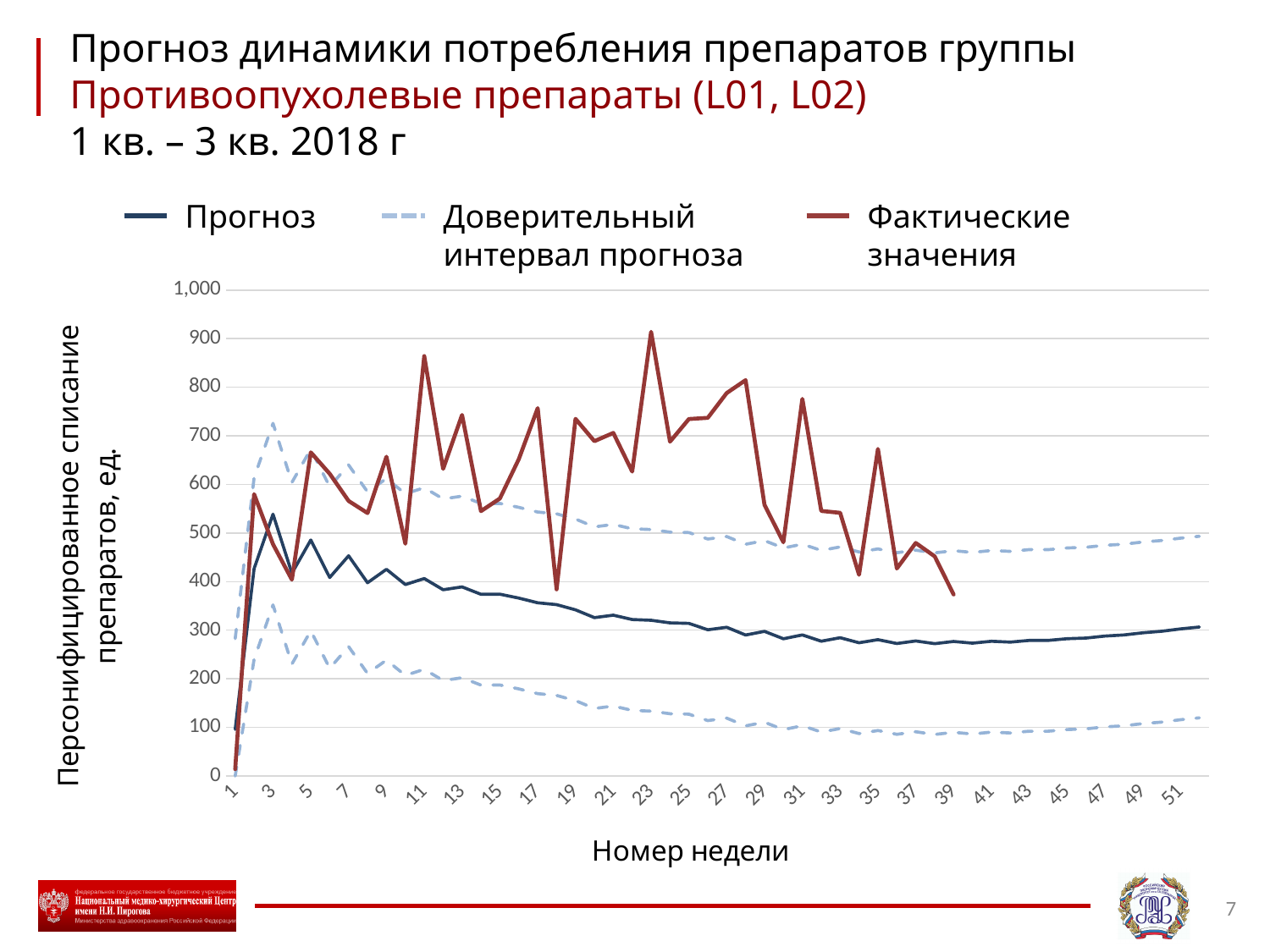
At which week number does the Фактические значения series reach its highest value? 23 Which is larger: the Фактические значения value at week 11 or at week 23? week 23 What is the highest value shown on the y axis? 1,000 How many series does the legend list? 3 Is the value of Фактические значения at week 23 greater or less than 800? greater Is the value of Прогноз at week 51 greater or less than 400? less Which series is drawn with a dashed line? Доверительный интервал прогноза Is the value of Фактические значения at week 39 greater or less than 500? less What are the three series named in the legend? Прогноз, Доверительный интервал прогноза, Фактические значения What kind of chart is shown on the slide? line chart Between week 5 and week 35, does the Прогноз line rise or fall? fall What is the title of the x axis? Номер недели